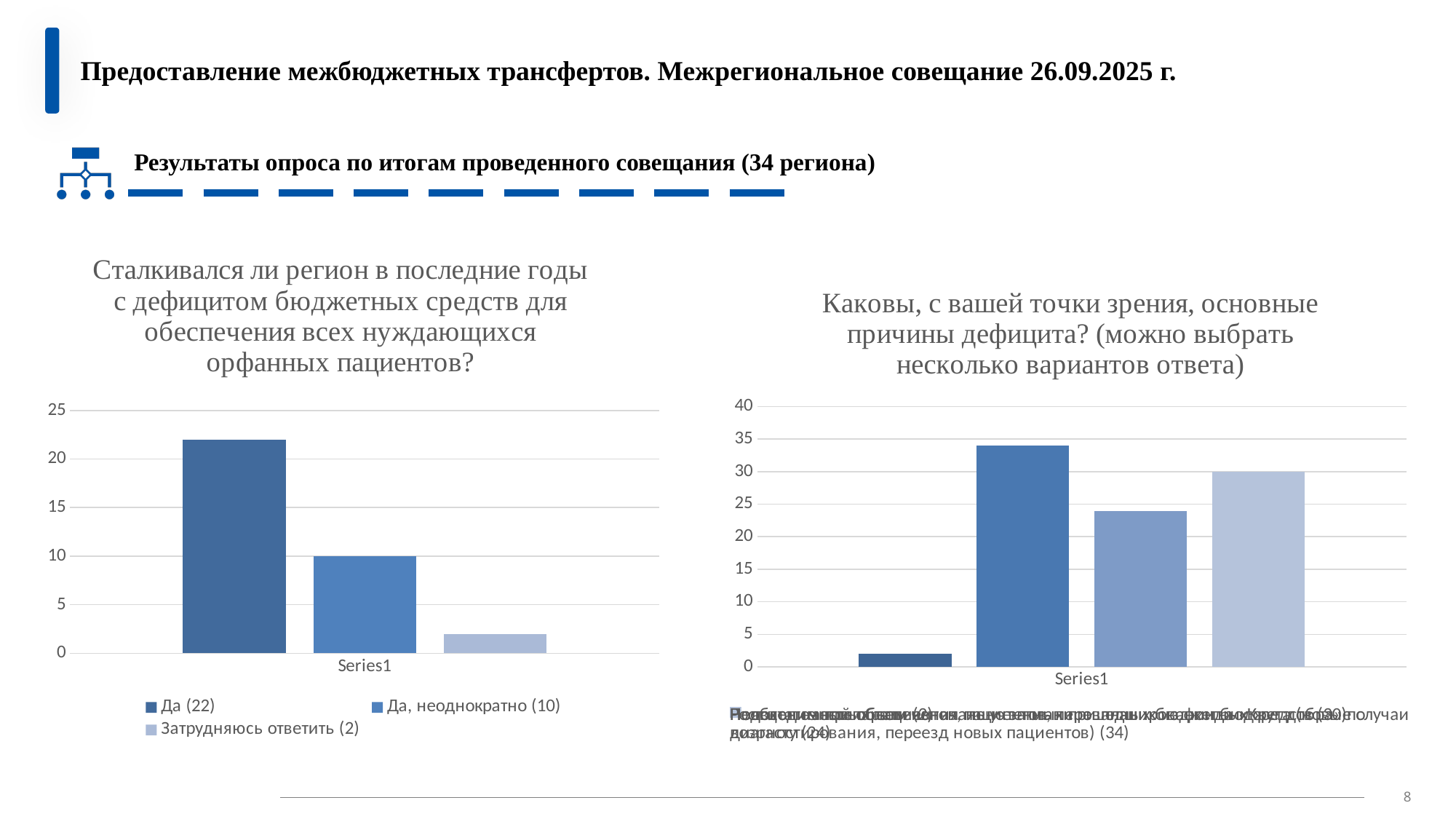
On the left chart, which category has the highest value? Да (22) On the left chart, what is the difference between the values for "Да" and "Да, неоднократно"? 12 On the left chart, which is larger: the value for "Да, неоднократно" or for "Затрудняюсь ответить"? Да, неоднократно On the right chart, is the value of the second bar from the left greater or less than 30? greater What kind of chart is the left chart? Bar chart On the left chart, which category has the lowest value? Затрудняюсь ответить (2) On the left chart, how many entries does the legend list? 3 On the left chart, what is the value for "Да, неоднократно"? 10 On the left chart, what is the value for "Затрудняюсь ответить"? 2 On the right chart, is the value of the leftmost bar greater or less than 5? less On the left chart, what is the value for "Да"? 22 On the right chart, how many bars are plotted? 4